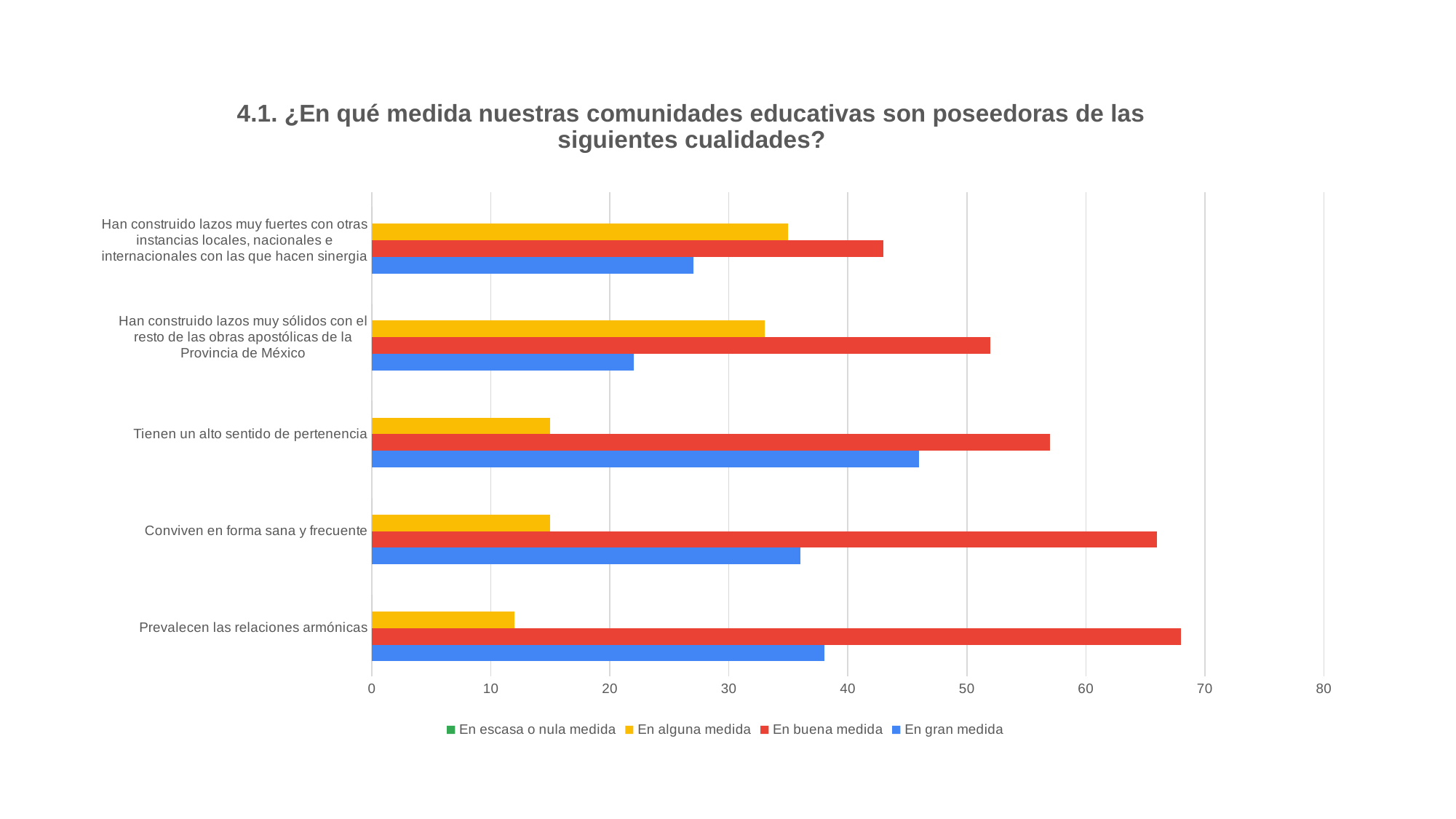
Is the value for 'En alguna medida' in 'Prevalecen las relaciones armónicas' greater or less than 20? less Is the value for 'En buena medida' in 'Conviven en forma sana y frecuente' greater or less than 60? greater Is the value for 'En gran medida' in 'Han construido lazos muy sólidos con el resto de las obras apostólicas de la Provincia de México' greater or less than 30? less What kind of chart is shown on the slide? Bar chart Which category has the lowest value for 'En buena medida'? Han construido lazos muy fuertes con otras instancias locales, nacionales e internacionales con las que hacen sinergia Which category has the highest value for 'En gran medida'? Tienen un alto sentido de pertenencia For 'Tienen un alto sentido de pertenencia', which is larger: 'En buena medida' or 'En gran medida'? En buena medida Which legend entry is shown in red? En buena medida Which category has the lowest value for 'En alguna medida'? Prevalecen las relaciones armónicas How many categories are plotted on the chart? 5 How many series does the legend list? 4